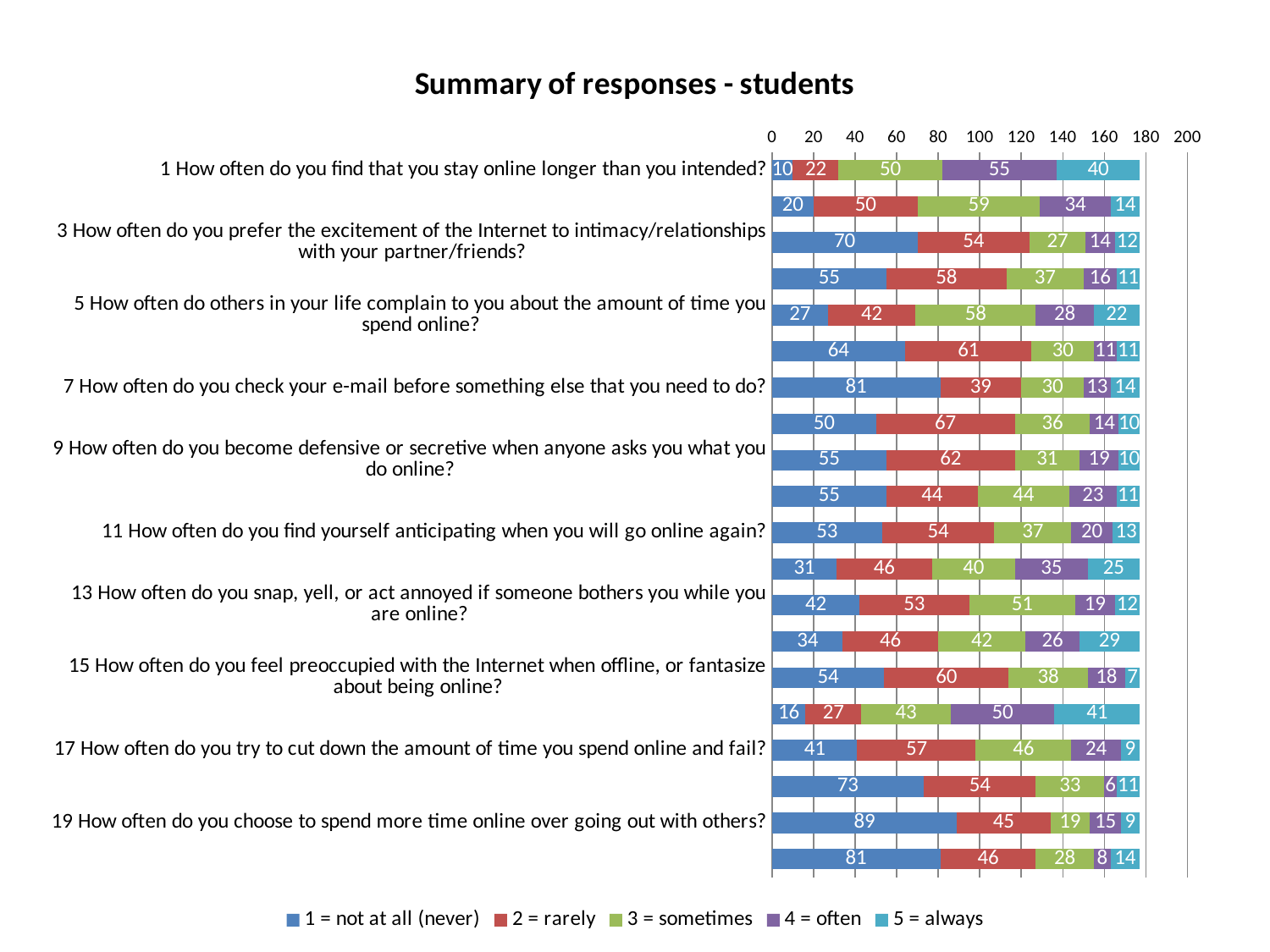
What is the total of the stacked bar for question 1, 'How often do you find that you stay online longer than you intended?' 177 What is the '2 = rarely' value for question 17, 'How often do you try to cut down the amount of time you spend online and fail?' 57 What is the '1 = not at all (never)' value for question 19, 'How often do you choose to spend more time online over going out with others?' 89 What kind of chart is shown on the slide? stacked bar chart How many series does the legend list? 5 What is the '3 = sometimes' value for question 7, 'How often do you check your e-mail before something else that you need to do?' 30 Which is larger for question 3, 'How often do you prefer the excitement of the Internet to intimacy/relationships with your partner/friends?': the '1 = not at all (never)' value or the '2 = rarely' value? 1 = not at all (never) Which series has the highest value for question 5, 'How often do others in your life complain to you about the amount of time you spend online?' 3 = sometimes What is the '1 = not at all (never)' value for question 1, 'How often do you find that you stay online longer than you intended?' 10 What is the difference between the '1 = not at all (never)' value for question 19 and the '1 = not at all (never)' value for question 1? 79 What is the title of the chart? Summary of responses - students What is the '5 = always' value for question 1, 'How often do you find that you stay online longer than you intended?' 40